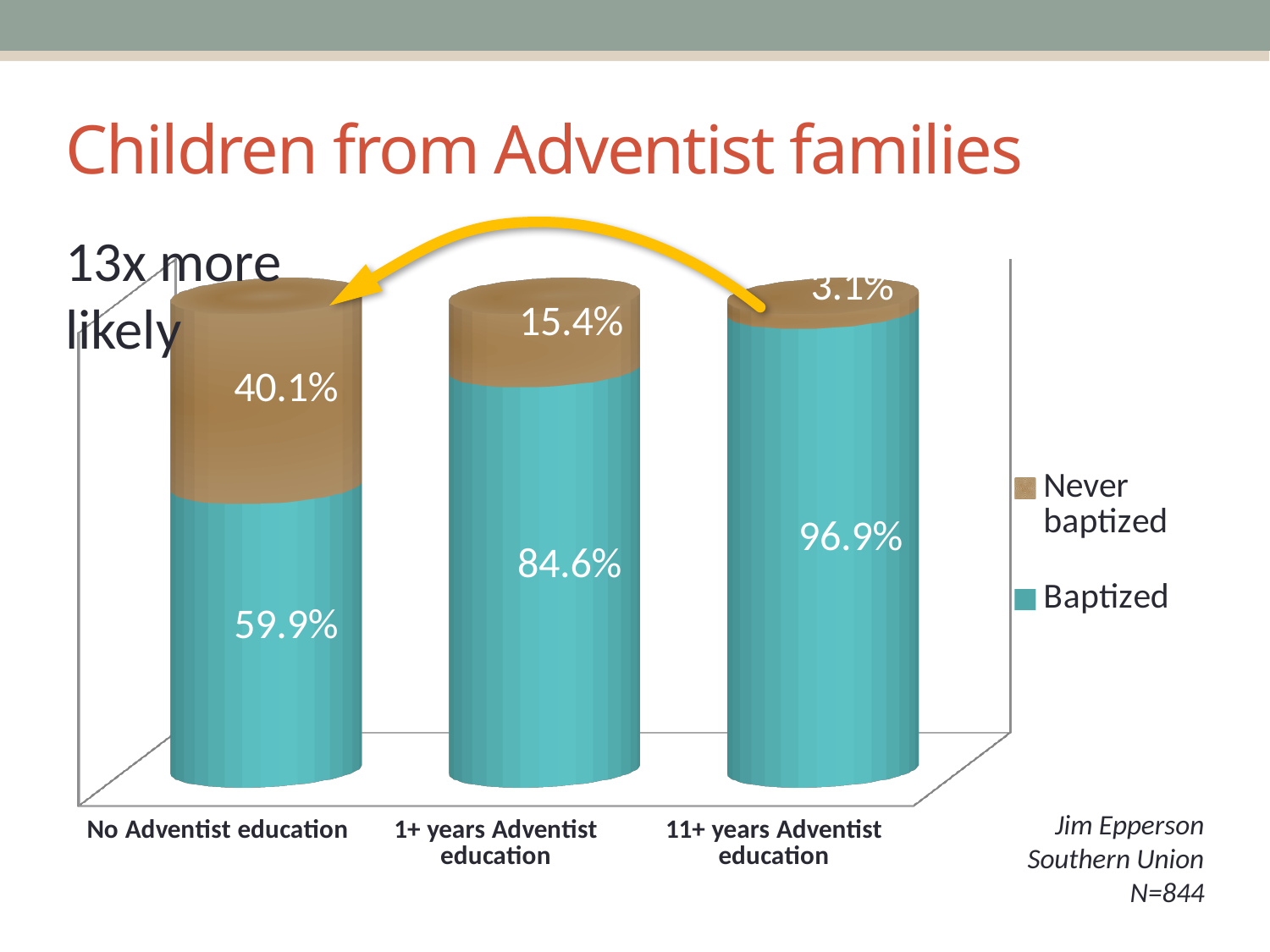
What percentage of children with no Adventist education were baptized? 59.9% Does the Baptized percentage rise or fall as years of Adventist education increase along the x axis? Rise What is the Never baptized value for children with 1+ years Adventist education? 15.4% How many series does the legend list? 2 Which category has the lowest Never baptized percentage? 11+ years Adventist education What kind of chart is shown on the slide? Stacked bar chart What is the Baptized value for children with 11+ years Adventist education? 96.9% How many categories are shown on the x axis? 3 What is the Never baptized value for children with no Adventist education? 40.1% Which category has the highest Baptized percentage? 11+ years Adventist education Which is larger: the Never baptized value for no Adventist education or for 1+ years Adventist education? No Adventist education What is the difference between the Baptized percentages for 11+ years Adventist education and no Adventist education? 37.0 percentage points